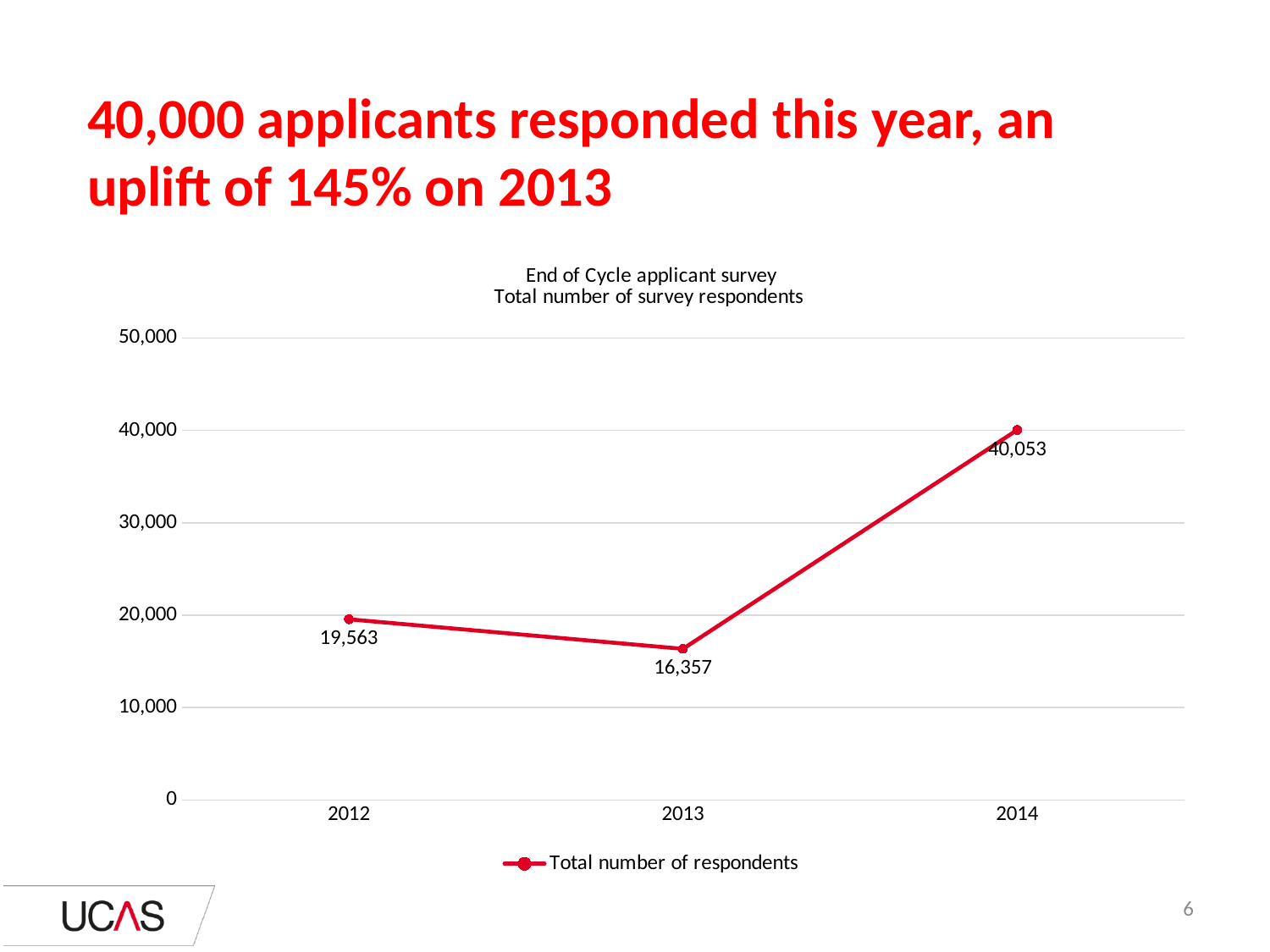
What was the total number of survey respondents in 2014? 40,053 What is the name of the series shown in the chart legend? Total number of respondents What is the difference in the number of respondents between 2012 and 2013? 3,206 What type of chart is shown on the slide? Line chart What was the total number of survey respondents in 2012? 19,563 Which year had more respondents, 2012 or 2013? 2012 Which year had the highest number of survey respondents? 2014 Is the number of respondents in 2014 greater or less than 30,000? greater What was the total number of survey respondents in 2013? 16,357 Which year had the lowest number of survey respondents? 2013 How many years are plotted on the chart? 3 What is the difference in the number of respondents between 2014 and 2013? 23,696